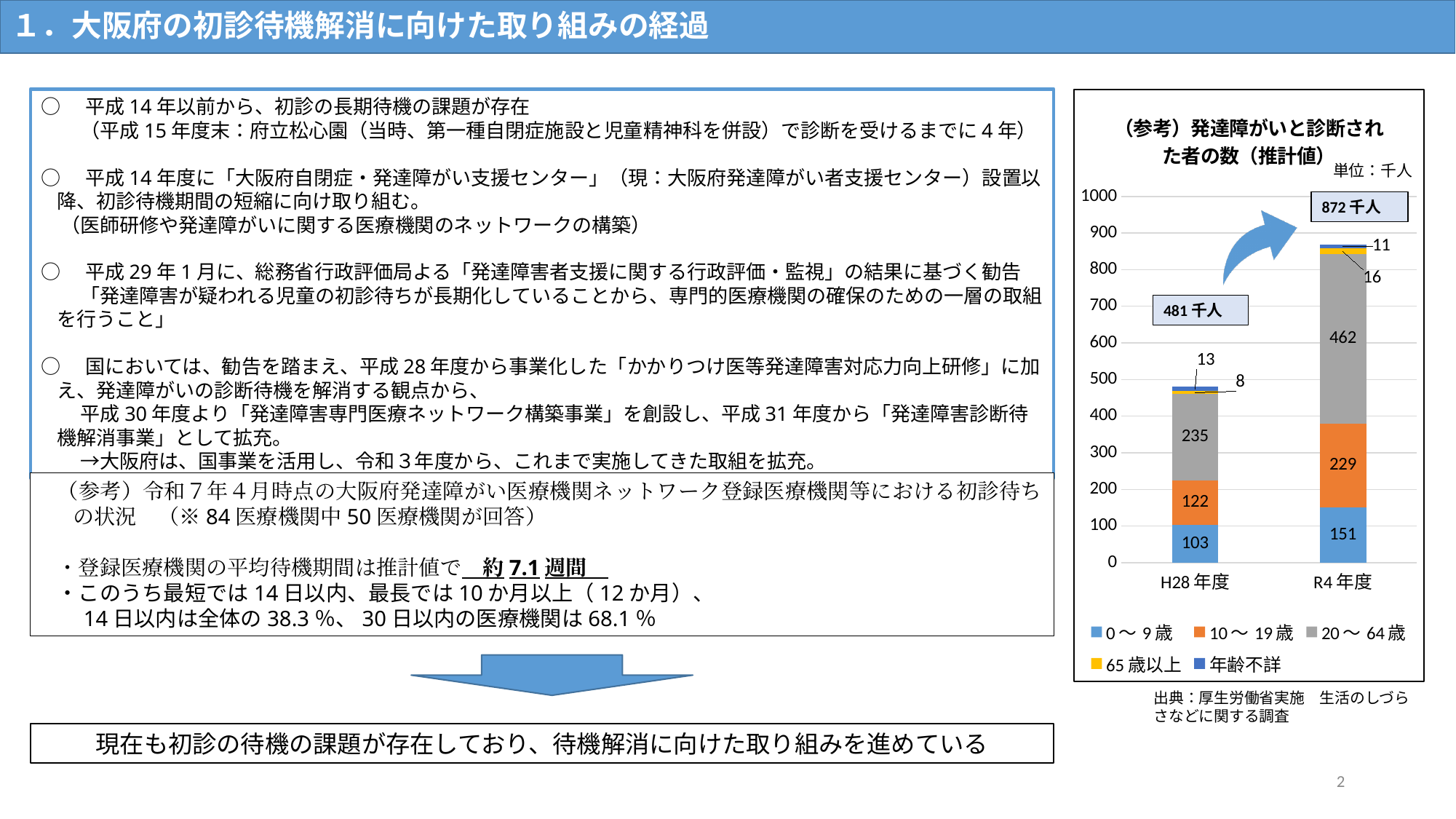
What is the difference in the 20～64歳 value between R4年度 and H28年度? 227 What is the value for 0～9歳 in H28年度? 103 Which age group has the largest value in the R4年度 bar? 20～64歳 How many categories (fiscal years) are shown on the x axis of the chart? 2 What kind of chart is shown on the slide? Stacked bar chart What is the value for 20～64歳 in R4年度? 462 How many series does the chart's legend list? 5 What unit is indicated for the values in the chart? 千人 What is the total shown for the H28年度 bar? 481千人 Which year has the larger value for 10～19歳, H28年度 or R4年度? R4年度 What is the total shown for the R4年度 bar? 872千人 What is the value for 10～19歳 in R4年度? 229